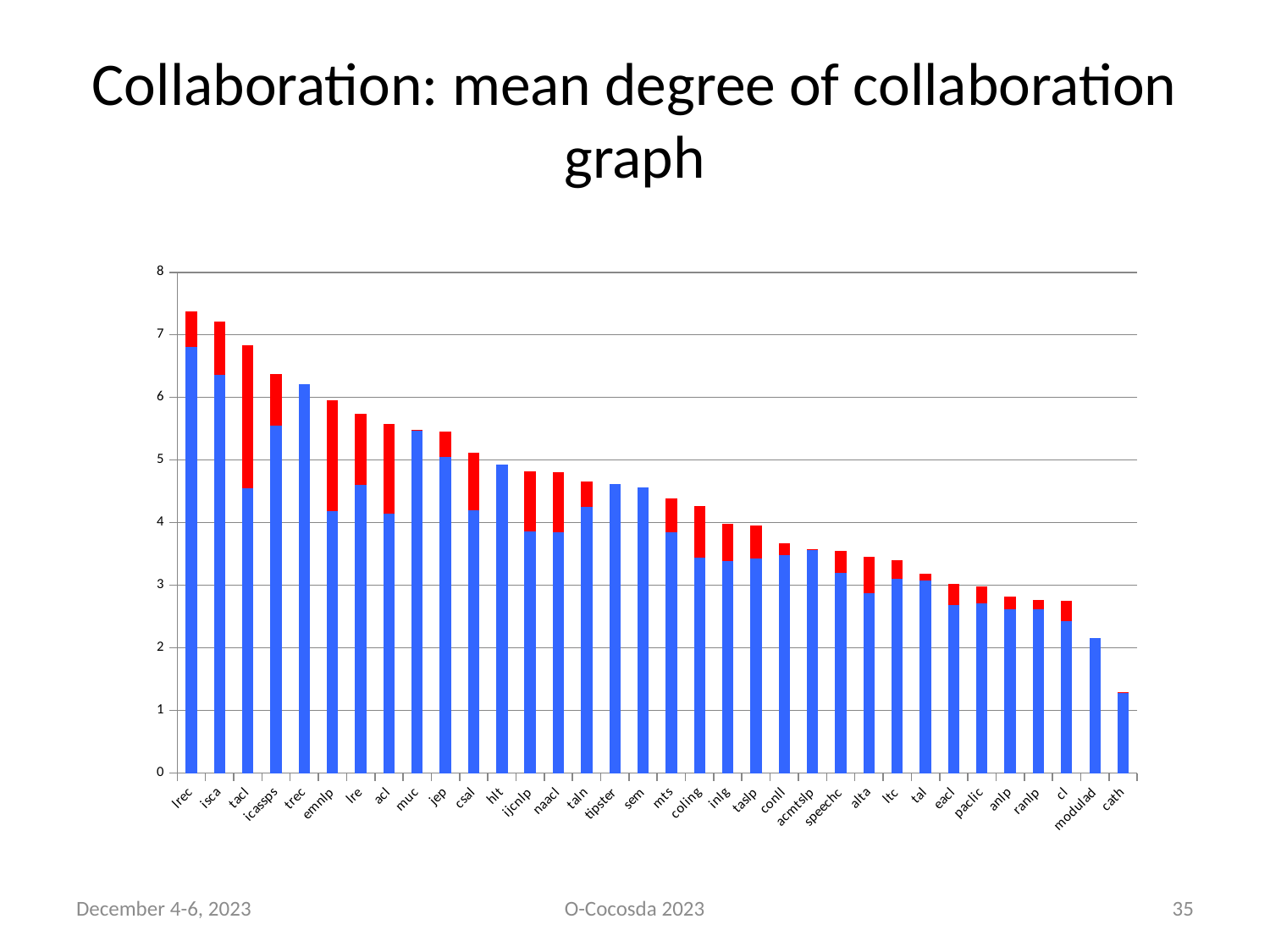
Which category has the lowest total bar? cath Which category has the highest total bar? lrec What kind of chart is shown on the slide? bar chart Is the total value for conll greater or less than 4? less What is the title of the chart on the slide? Collaboration: mean degree of collaboration graph Is the value for cath greater or less than 2? less Do the bar heights generally rise or fall from left to right along the x axis? fall Is the total value for lrec greater or less than 7? greater Which has the larger total bar, trec or tipster? trec How many categories are shown on the x axis? 34